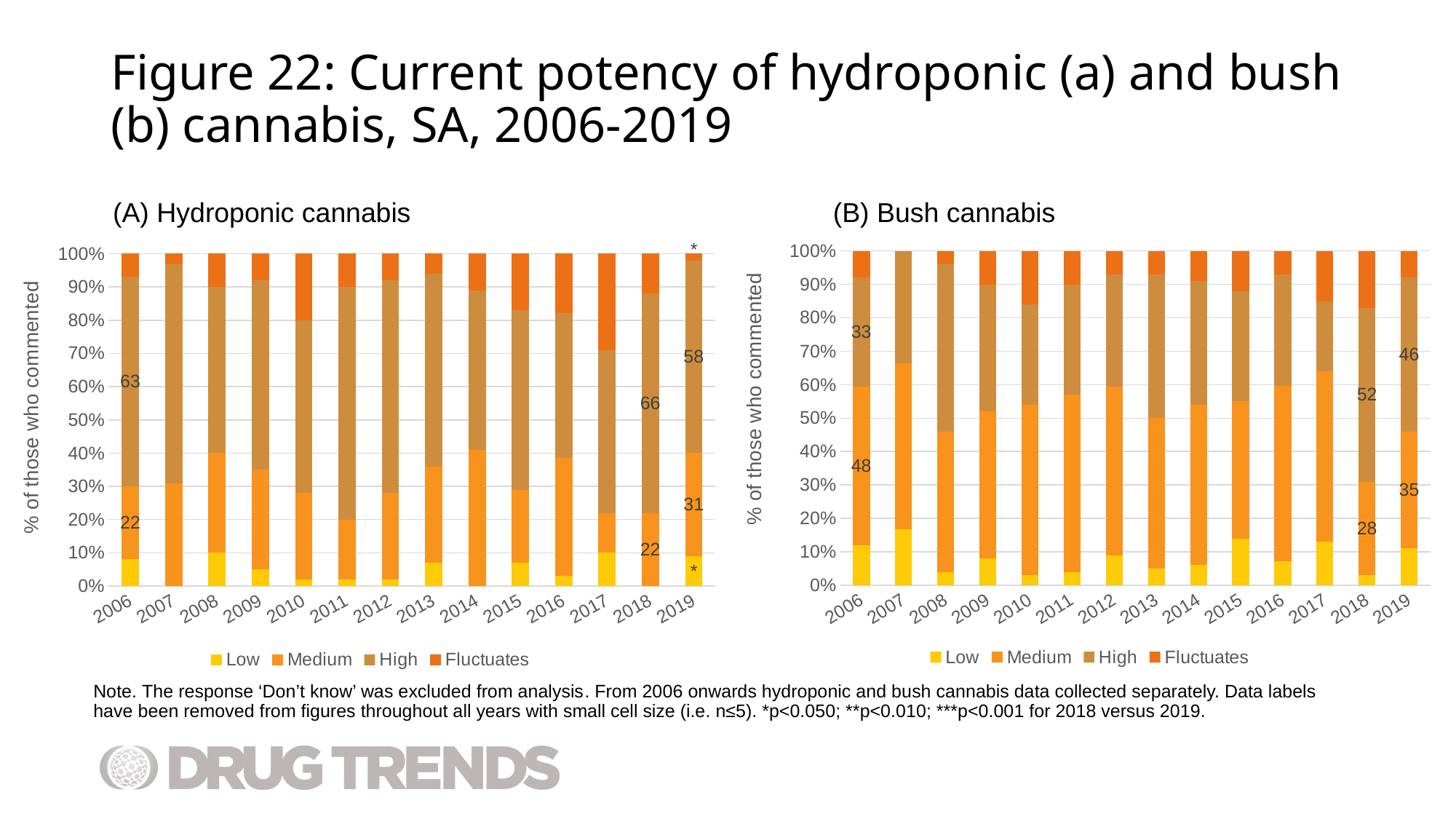
In the (B) Bush cannabis chart for 2006, which is larger: Medium or High? Medium How many series does the legend of the (A) Hydroponic cannabis chart list? 4 In the (A) Hydroponic cannabis chart, what is the labelled value for High in 2006? 63 What are the four legend entries in the (B) Bush cannabis chart? Low, Medium, High, Fluctuates In the (B) Bush cannabis chart, what is the difference between the Medium values for 2019 and 2018? 7 In the (A) Hydroponic cannabis chart, is the Low value for 2017 greater or less than 20%? less How many years are shown on the x axis of the (B) Bush cannabis chart? 14 What kind of chart is used for (A) Hydroponic cannabis? Stacked bar chart In the (B) Bush cannabis chart, what is the labelled value for Medium in 2006? 48 In the (A) Hydroponic cannabis chart, what is the labelled value for Medium in 2019? 31 In the (B) Bush cannabis chart, what is the labelled value for High in 2018? 52 In the (A) Hydroponic cannabis chart, what is the difference between the High values for 2018 and 2019? 8